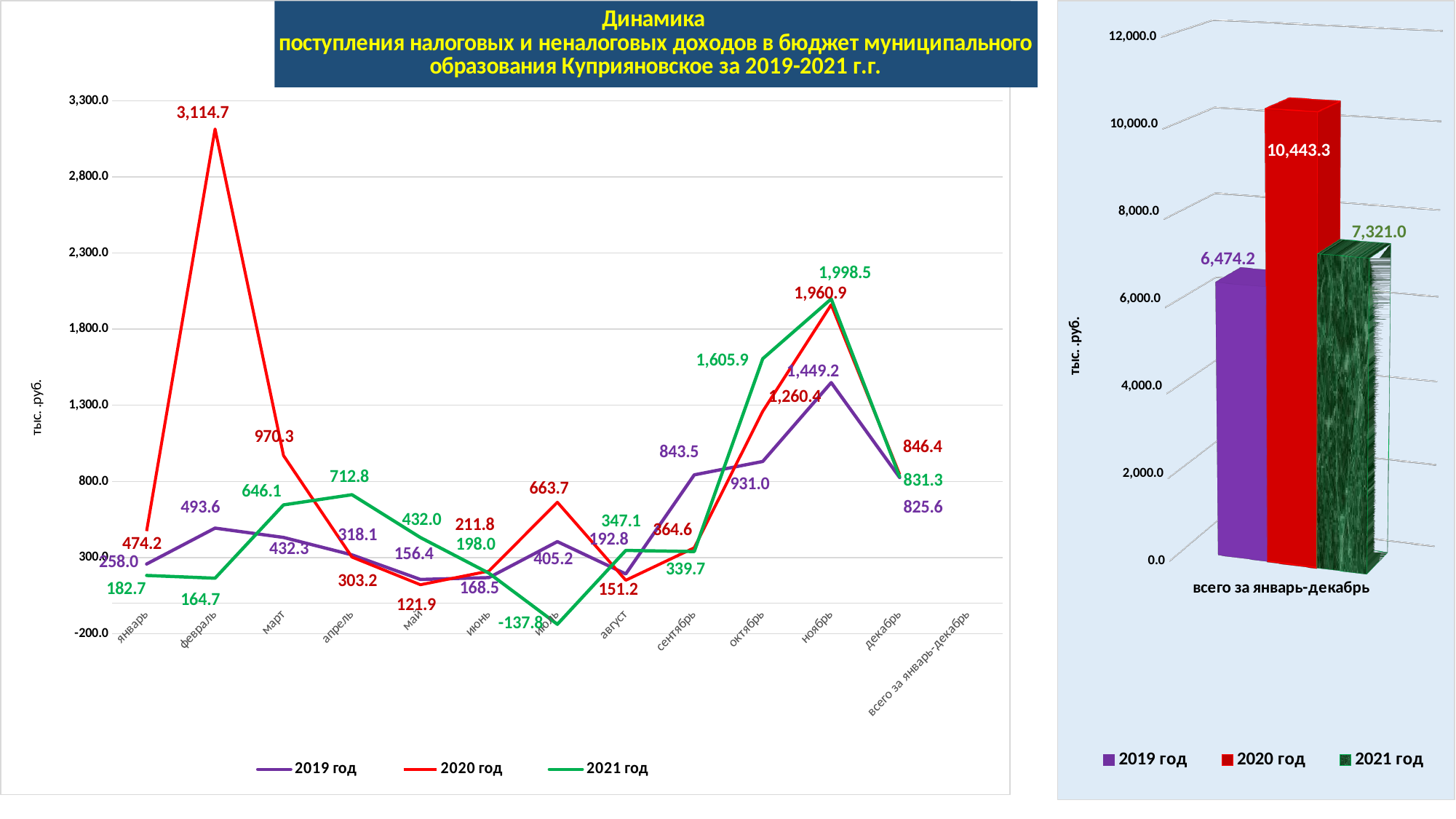
In the bar chart on the right, which year has the lowest total? 2019 год In the line chart on the left, what is the value for 2019 год in ноябрь? 1,449.2 In the line chart on the left, which is larger in сентябрь: 2019 год or 2020 год? 2019 год In the line chart on the left, what is the value for 2020 год in февраль? 3,114.7 In the bar chart on the right, how many series does the legend list? 3 In the line chart on the left, what is the value for 2021 год in июль? -137.8 What type of chart is shown on the right side of the slide? bar chart In the line chart on the left, what is the difference between the 2021 год and 2019 год values in апрель? 394.7 In the bar chart on the right, what is the value for 2020 год? 10,443.3 In the bar chart on the right, what is the difference between the 2020 год and 2021 год totals? 3,122.3 In the line chart on the left, does the 2020 год series rise or fall from февраль to май? fall In the line chart on the left, which series has the highest value in октябрь? 2021 год